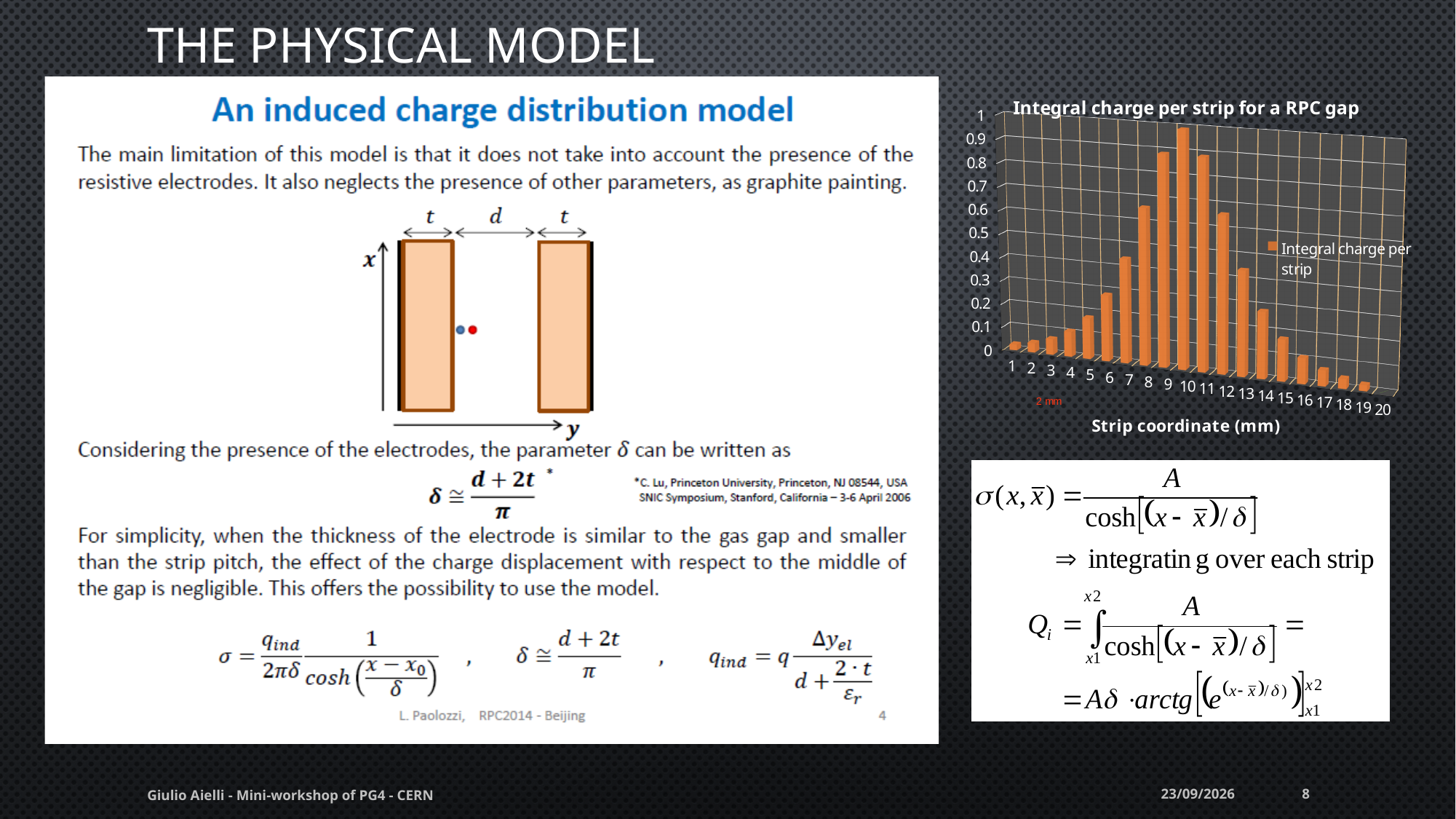
Is the value for strip 13 greater or less than 0.5? less Which strip has the highest integral charge in the chart? 10 How many series does the chart legend list? 1 What is the title of the chart? Integral charge per strip for a RPC gap Which has the larger integral charge, strip 8 or strip 13? strip 8 Which has the larger integral charge, strip 9 or strip 12? strip 9 What kind of chart is shown on the slide? bar chart Is the value for strip 1 greater or less than 0.1? less Is the value for strip 10 greater or less than 0.8? greater Do the values rise or fall from strip 10 to strip 20? fall How many strips (categories) are plotted along the x axis of the chart? 20